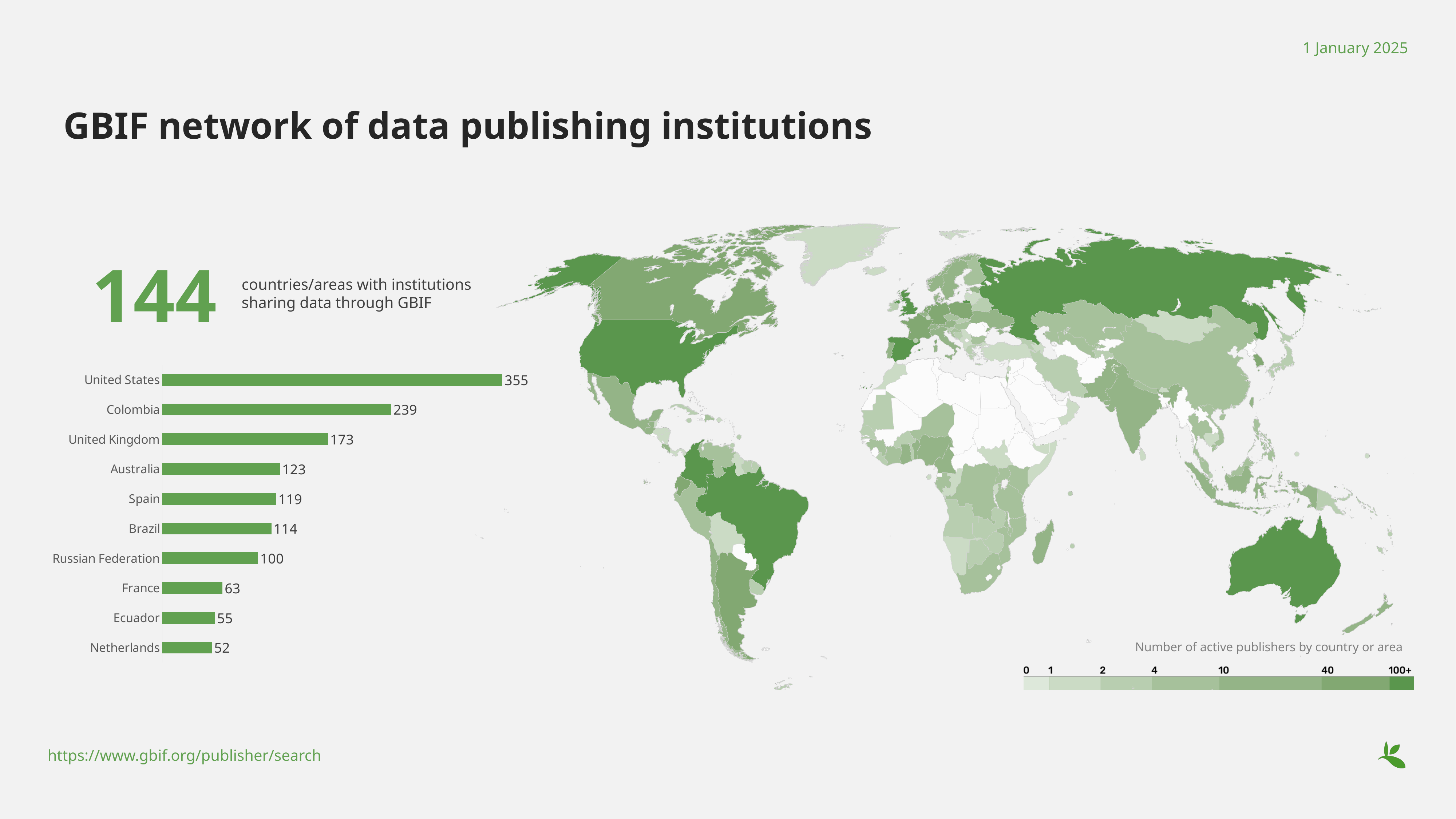
In the bar chart, which has a larger value, the United Kingdom or Brazil? United Kingdom In the bar chart, which country has the highest value? United States In the bar chart, what is the value for the Russian Federation? 100 What kind of chart is shown on the left of the slide? Bar chart In the bar chart, what is the difference between the values for the United States and Colombia? 116 According to the map legend, what does the colour shading on the map represent? Number of active publishers by country or area In the bar chart, what is the value for Colombia? 239 In the bar chart, which country has the lowest value? Netherlands In the bar chart, what is the value for Ecuador? 55 How many countries are shown in the bar chart? 10 In the bar chart, what is the value for the United States? 355 In the bar chart, what is the difference between the values for Australia and Spain? 4